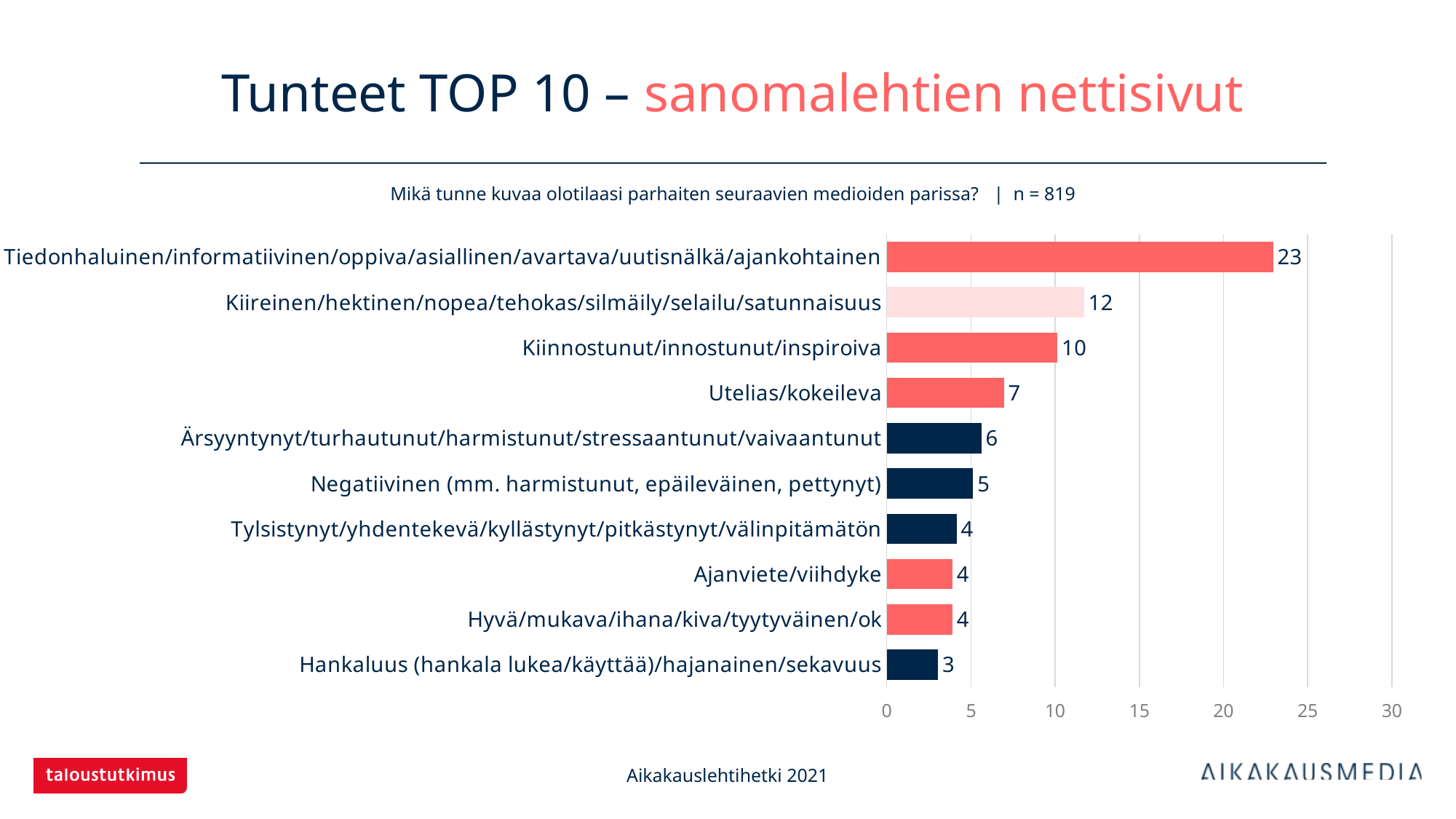
What is the value for Hankaluus (hankala lukea/käyttää)/hajanainen/sekavuus? 3 How many categories are shown in the chart? 10 What is the title of the slide? Tunteet TOP 10 – sanomalehtien nettisivut Which is larger, the value for Ärsyyntynyt/turhautunut/harmistunut/stressaantunut/vaivaantunut or the value for Negatiivinen (mm. harmistunut, epäileväinen, pettynyt)? Ärsyyntynyt/turhautunut/harmistunut/stressaantunut/vaivaantunut What is the value for Kiireinen/hektinen/nopea/tehokas/silmäily/selailu/satunnaisuus? 12 Which category has the lowest value? Hankaluus (hankala lukea/käyttää)/hajanainen/sekavuus What is the value for Utelias/kokeileva? 7 What kind of chart is shown on the slide? bar chart What is the sample size (n) stated on the slide? n = 819 Is the value for Tiedonhaluinen/informatiivinen/oppiva/asiallinen/avartava/uutisnälkä/ajankohtainen greater or less than 20? greater Which category has the highest value? Tiedonhaluinen/informatiivinen/oppiva/asiallinen/avartava/uutisnälkä/ajankohtainen What is the difference between the values for Tiedonhaluinen/informatiivinen/oppiva/asiallinen/avartava/uutisnälkä/ajankohtainen and Kiinnostunut/innostunut/inspiroiva? 13